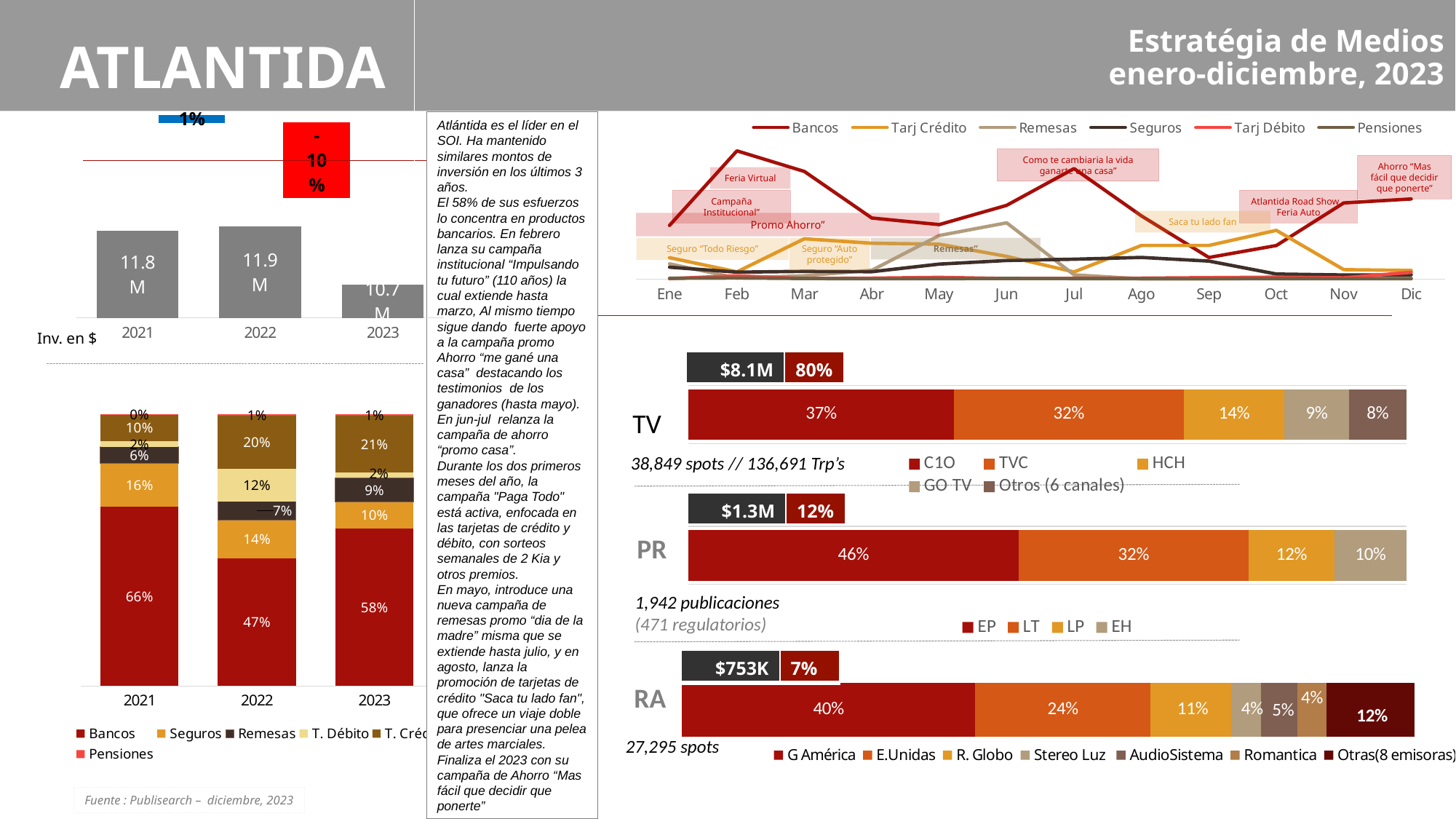
In the stacked bar chart at the bottom left, how many series does the legend list? 6 In the investment bar chart at the top left (Inv. en $), what is the value for 2022? 11.9 M In the RA stacked bar on the right, is the share for G América larger than the share for E.Unidas? Yes, G América (40%) In the stacked bar chart at the bottom left, what is the difference between the Bancos share in 2021 and in 2022? 19% In the TV stacked bar on the right, what share does C1O have? 37% In the investment bar chart at the top left (Inv. en $), which year has the lowest investment? 2023 In the PR stacked bar on the right, which channel has the largest share? EP In the stacked bar chart at the bottom left, what share does T. Crédito have in 2023? 21% In the investment bar chart at the top left (Inv. en $), what percentage change is shown for 2023? -10% In the line chart at the top right, which series is plotted in dark red? Bancos In the line chart at the top right, how many months are shown on the x axis? 12 In the stacked bar chart at the bottom left, what share does Bancos have in 2021? 66%